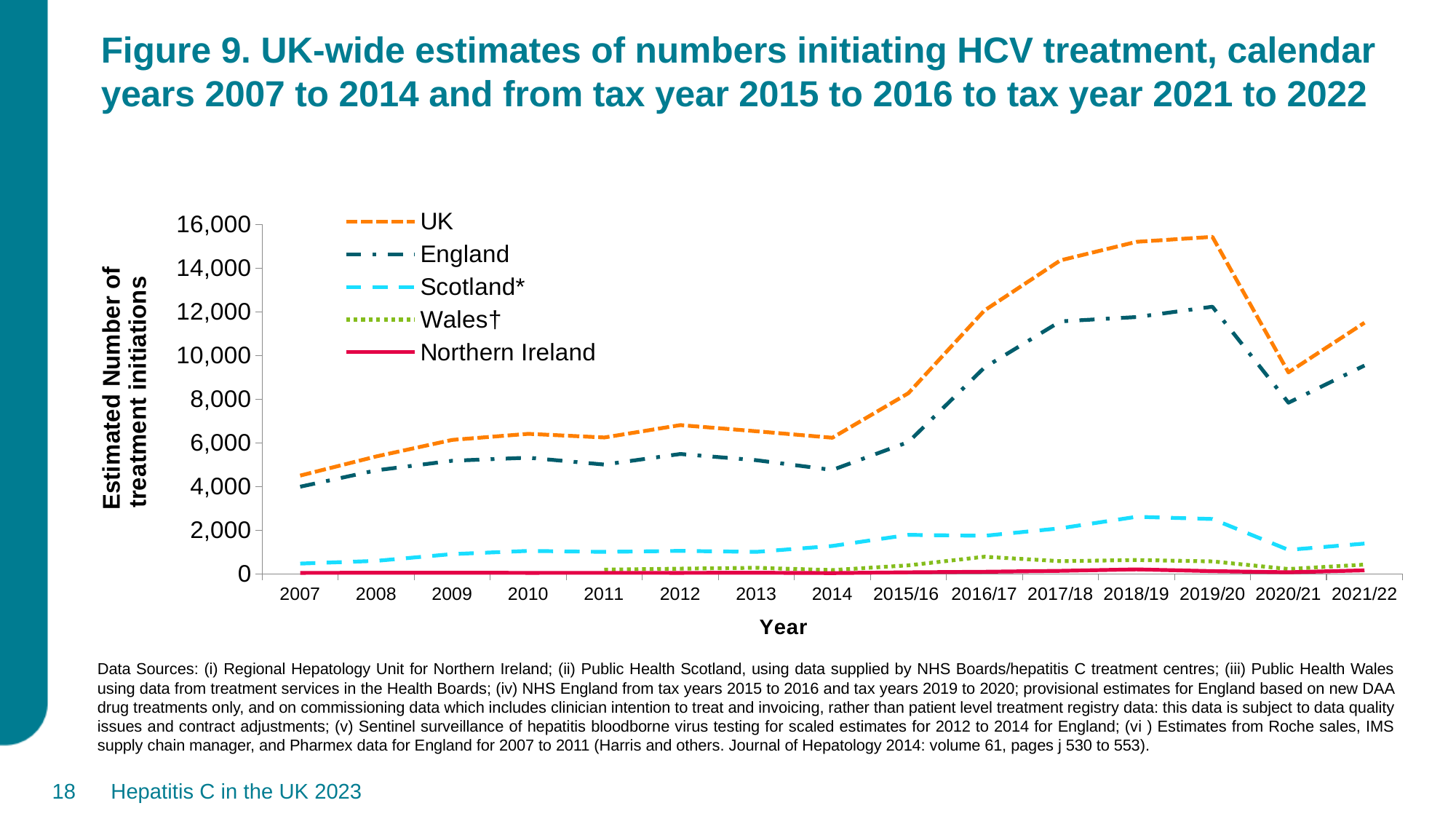
What kind of chart is shown on the slide? line chart How many series does the legend list? 5 Which series has the lowest values across the whole chart? Northern Ireland In which year is the UK value lowest? 2007 Is the UK value for 2020/21 greater or less than 10,000? less Does the UK line rise or fall between 2014 and 2019/20? rises Is the UK value for 2019/20 greater or less than 14,000? greater In 2018/19, which is larger: the England value or the Scotland* value? England Does the UK line rise or fall between 2019/20 and 2020/21? falls What is the title of the x axis? Year Is the Scotland* value for 2018/19 greater or less than 2,000? greater How many time points are shown along the x axis? 15